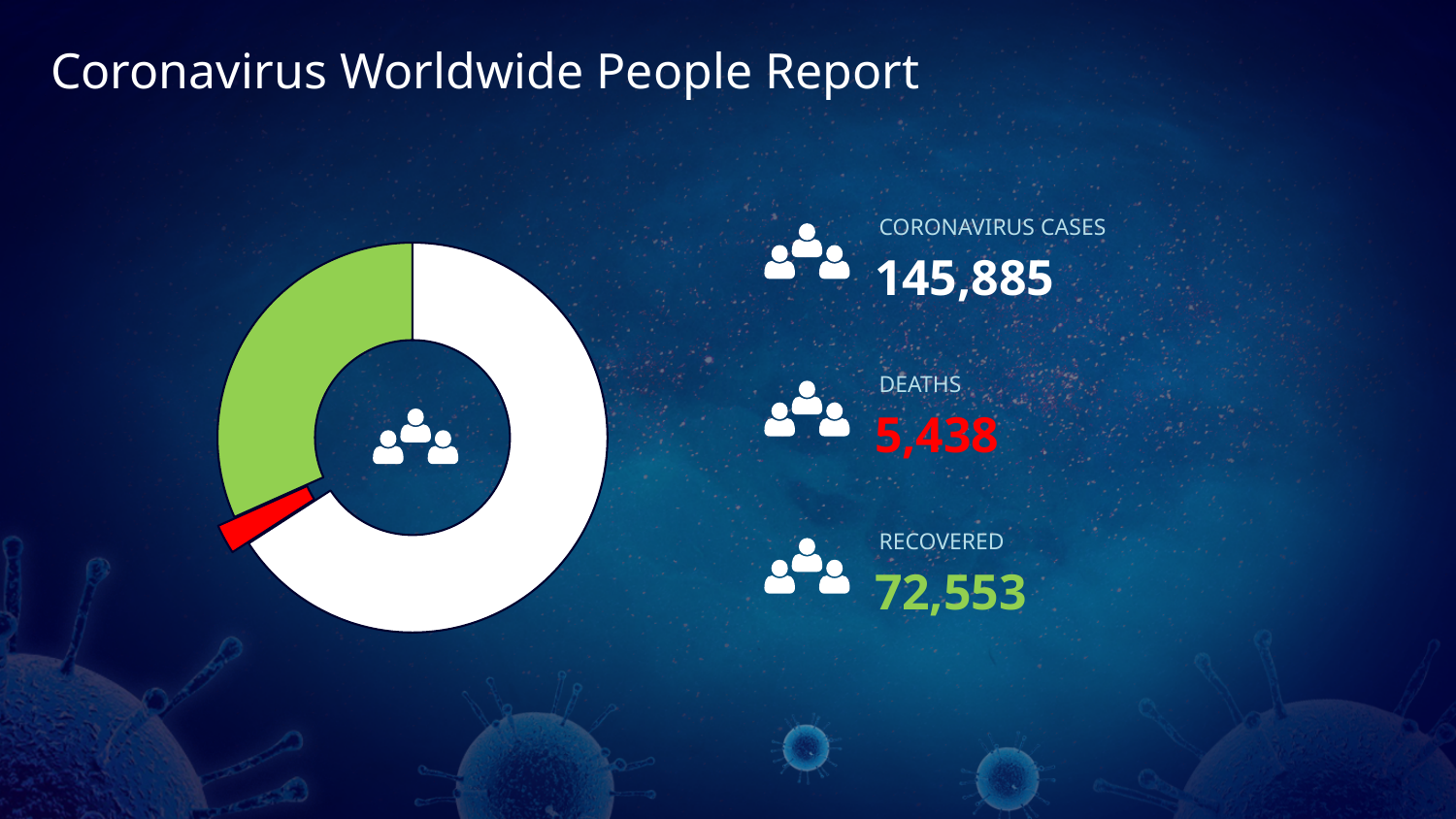
What is the title of the slide? Coronavirus Worldwide People Report What is the number of recovered people shown on the slide? 72,553 Which is larger, the number of deaths or the number recovered? Recovered What is the difference between the number of coronavirus cases and the number recovered? 73,332 Which colour segment of the donut chart is the smallest? Red What is the number of coronavirus cases shown on the slide? 145,885 In what colour is the deaths figure printed on the slide? Red What is the number of deaths shown on the slide? 5,438 How many segments does the donut chart have? 3 Which colour segment of the donut chart is the largest? White What kind of chart is shown on the slide? Donut (pie) chart What is the difference between the number recovered and the number of deaths? 67,115